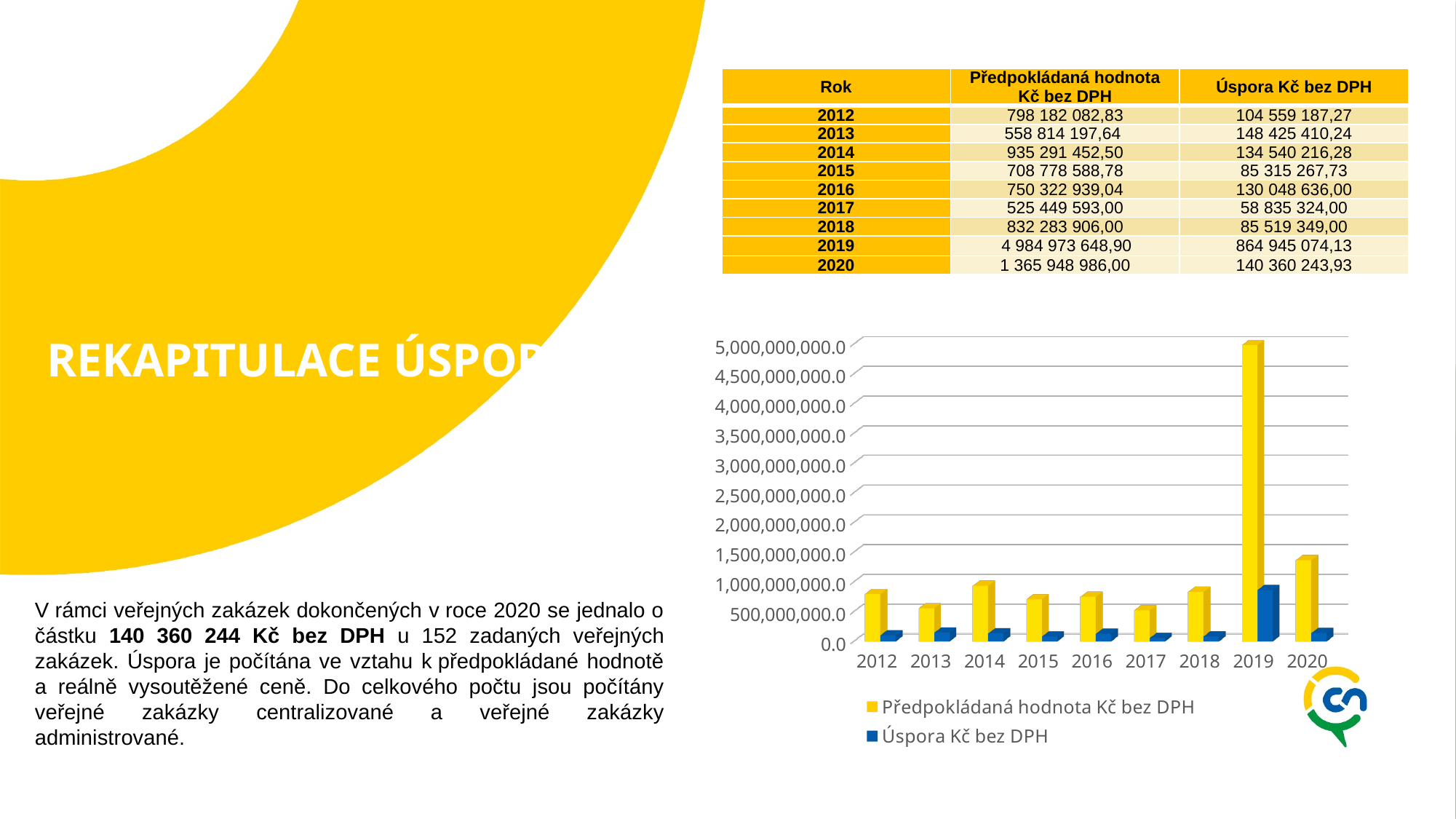
How many years are shown on the x axis of the chart? 9 Which year has the highest Předpokládaná hodnota Kč bez DPH? 2019 Is the Předpokládaná hodnota Kč bez DPH for 2019 greater or less than 4,500,000,000.0? greater How many series does the chart legend list? 2 Which series is shown in blue in the chart? Úspora Kč bez DPH Which is larger, the Předpokládaná hodnota Kč bez DPH for 2014 or for 2015? 2014 What is the Předpokládaná hodnota Kč bez DPH for 2019? 4 984 973 648,90 Which year has the lowest Úspora Kč bez DPH? 2017 What is the Úspora Kč bez DPH for 2020? 140 360 243,93 Is the Úspora Kč bez DPH for 2019 greater or less than 1,000,000,000.0? less What is the difference between the Předpokládaná hodnota Kč bez DPH and the Úspora Kč bez DPH for 2020? 1 225 588 742,07 What kind of chart is shown on the slide? bar chart